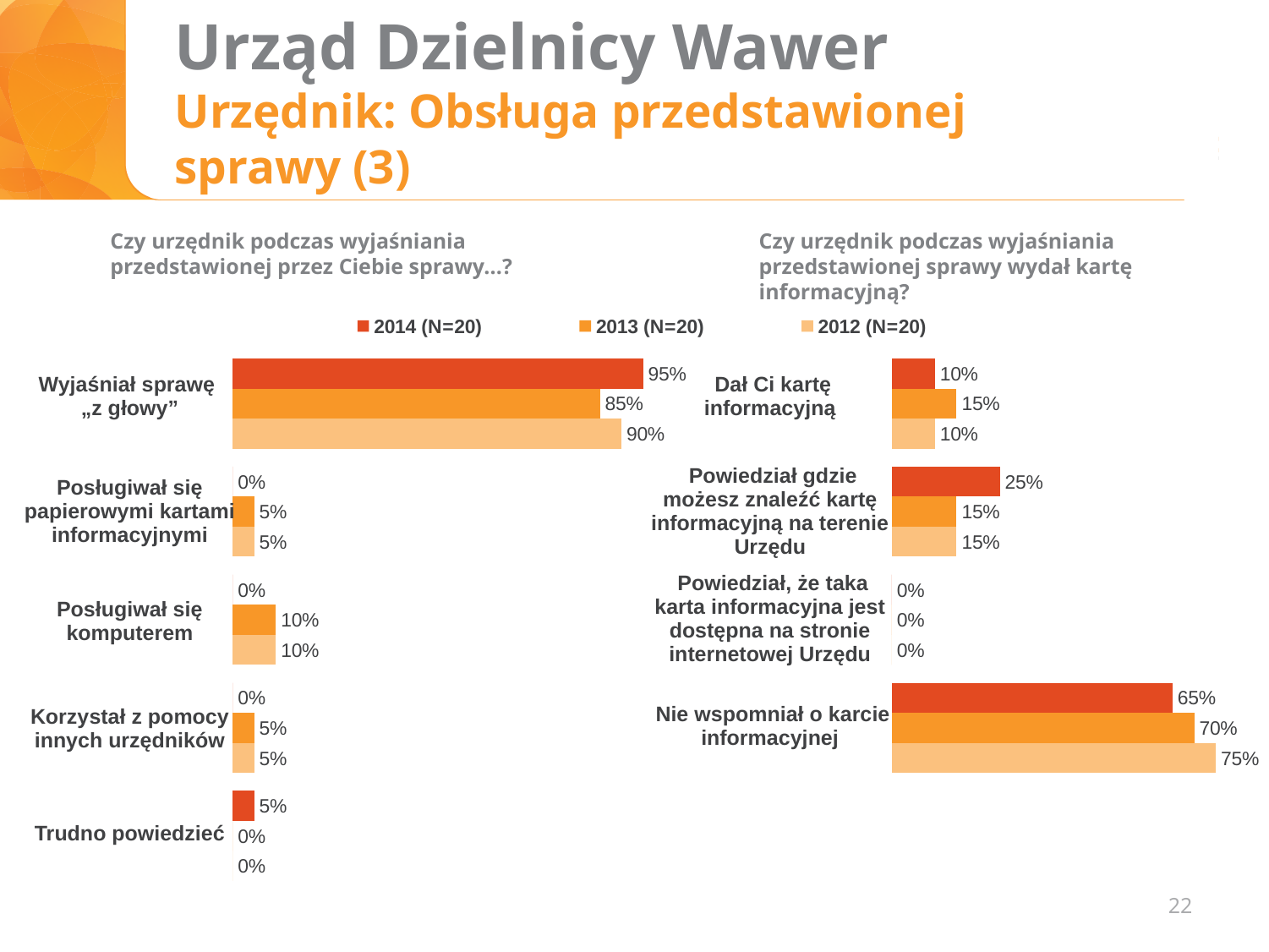
In the right chart, what is the 2014 value for "Powiedział gdzie możesz znaleźć kartę informacyjną na terenie Urzędu"? 25% How many series does the legend list? 3 In the right chart, what is the difference between the 2012 and 2014 values for "Nie wspomniał o karcie informacyjnej"? 10% In the left chart, which category has the highest 2012 value? Wyjaśniał sprawę „z głowy” In the left chart ("Czy urzędnik podczas wyjaśniania przedstawionej przez Ciebie sprawy...?"), what is the 2014 value for "Wyjaśniał sprawę „z głowy”"? 95% What type of chart is used on this slide? Bar chart How many categories does the left chart show? 5 In the right chart, which is larger for "Dał Ci kartę informacyjną": the 2013 value or the 2014 value? 2013 In the right chart ("Czy urzędnik podczas wyjaśniania przedstawionej sprawy wydał kartę informacyjną?"), what is the 2012 value for "Nie wspomniał o karcie informacyjnej"? 75% In the right chart, which category has the lowest values across all three years? Powiedział, że taka karta informacyjna jest dostępna na stronie internetowej Urzędu In the left chart, what is the 2013 value for "Posługiwał się komputerem"? 10% In the left chart, what is the difference between the 2014 and 2013 values for "Wyjaśniał sprawę „z głowy”"? 10%